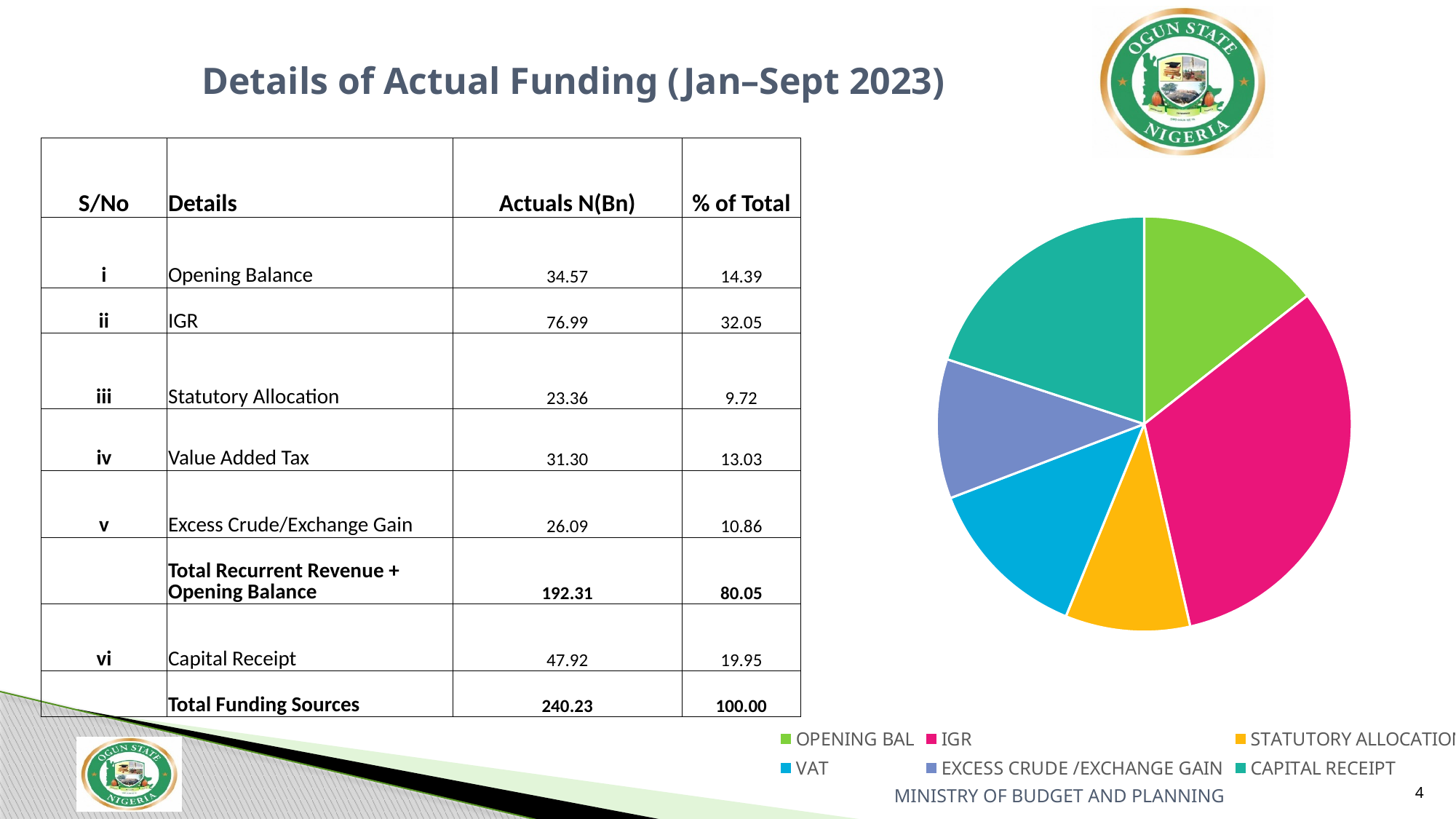
What is the actual value in N(Bn) for Value Added Tax in the table? 31.30 What share of total funding does the Capital Receipt slice represent, according to the table? 19.95 What is the actual value in N(Bn) for Opening Balance in the table? 34.57 What is the difference in N(Bn) between IGR and Opening Balance in the table? 42.42 How many slices does the pie chart have? 6 What colour is the IGR slice in the pie chart? pink What share of total funding does the IGR slice represent, according to the table? 32.05 How many entries does the pie chart's legend list? 6 What kind of chart is shown on the slide? pie chart Which funding source has the largest slice in the pie chart? IGR Which funding source has the smallest slice in the pie chart? Statutory Allocation Which slice is larger in the pie chart, Capital Receipt or Opening Bal? Capital Receipt